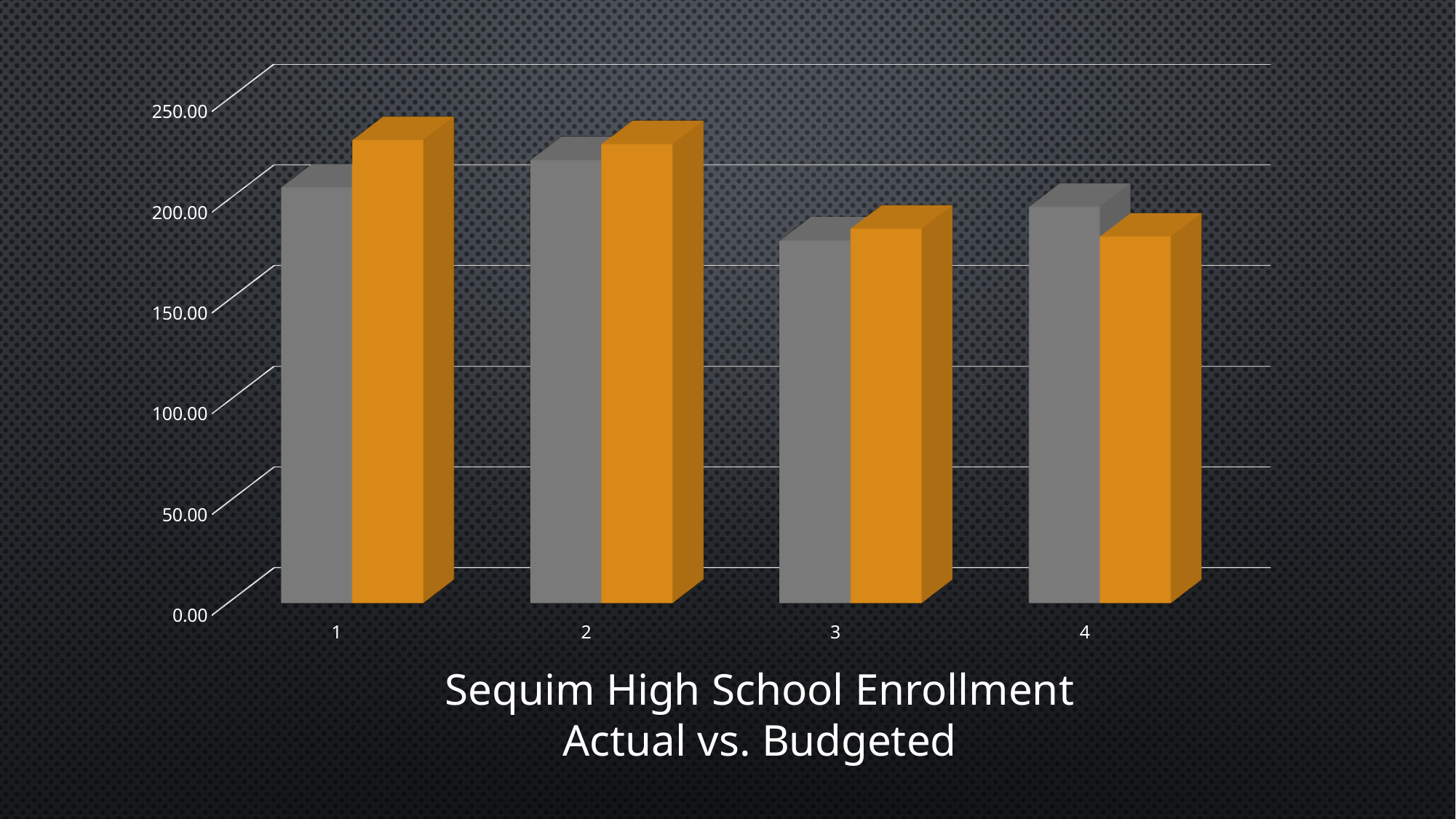
Is the value of the gray bar for category 1 greater or less than 200? greater What kind of chart is shown on the slide? Bar chart Is the value of the orange bar for category 1 greater or less than 250? less How many bars are plotted for each category? 2 For category 1, which bar is taller, the gray bar or the orange bar? The orange bar What is the title of the chart? Sequim High School Enrollment Actual vs. Budgeted How many categories are shown along the x axis? 4 What two colours are used for the bars? Gray and orange Is the value of the gray bar for category 3 greater or less than 200? less Among the gray bars, which category has the highest value? 2 For category 4, which bar is taller, the gray bar or the orange bar? The gray bar